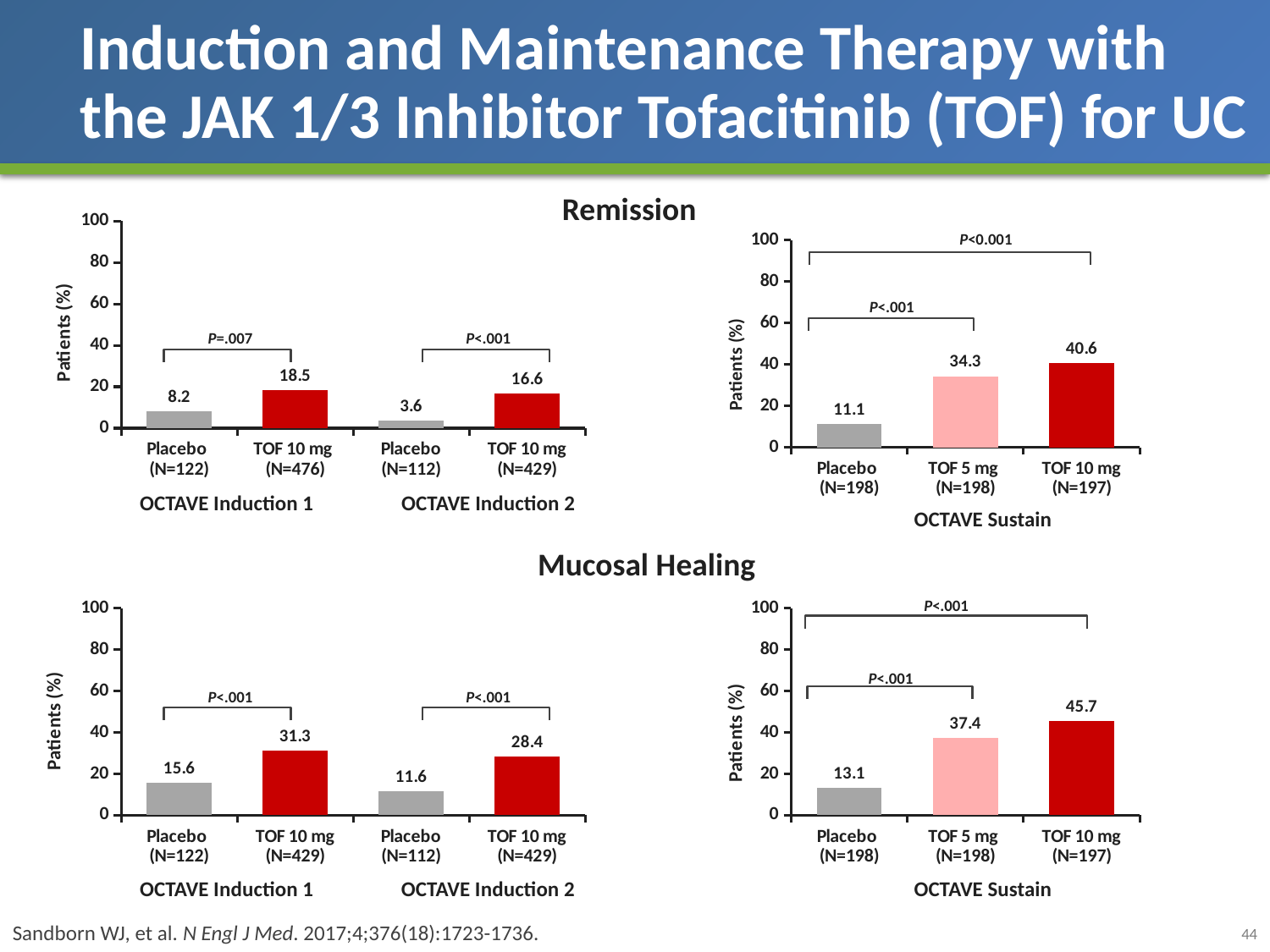
What type of chart is used for the Mucosal Healing OCTAVE Induction data (bottom left)? Bar chart In the Mucosal Healing chart for OCTAVE Sustain (bottom right), which group has the lowest value? Placebo In the Remission chart for OCTAVE Sustain (top right), what is the value for TOF 5 mg? 34.3 In the Mucosal Healing chart for OCTAVE Induction 1 (bottom left), what is the difference between TOF 10 mg and Placebo? 15.7 In the Mucosal Healing chart for OCTAVE Sustain (bottom right), is the value for TOF 10 mg greater or less than 40? greater How many bars are shown in the Remission chart for OCTAVE Sustain (top right)? 3 In the Mucosal Healing chart for OCTAVE Induction 2 (bottom left), which is larger, Placebo or TOF 10 mg? TOF 10 mg In the Remission chart for OCTAVE Induction 1 (top left), what is the value for TOF 10 mg? 18.5 In the Remission chart for OCTAVE Sustain (top right), what is the difference between TOF 10 mg and Placebo? 29.5 In the Remission chart for OCTAVE Induction 2 (top left), what is the value for Placebo? 3.6 In the Remission chart for OCTAVE Sustain (top right), which group has the highest value? TOF 10 mg What is the y-axis label on the Remission chart for OCTAVE Sustain (top right)? Patients (%)